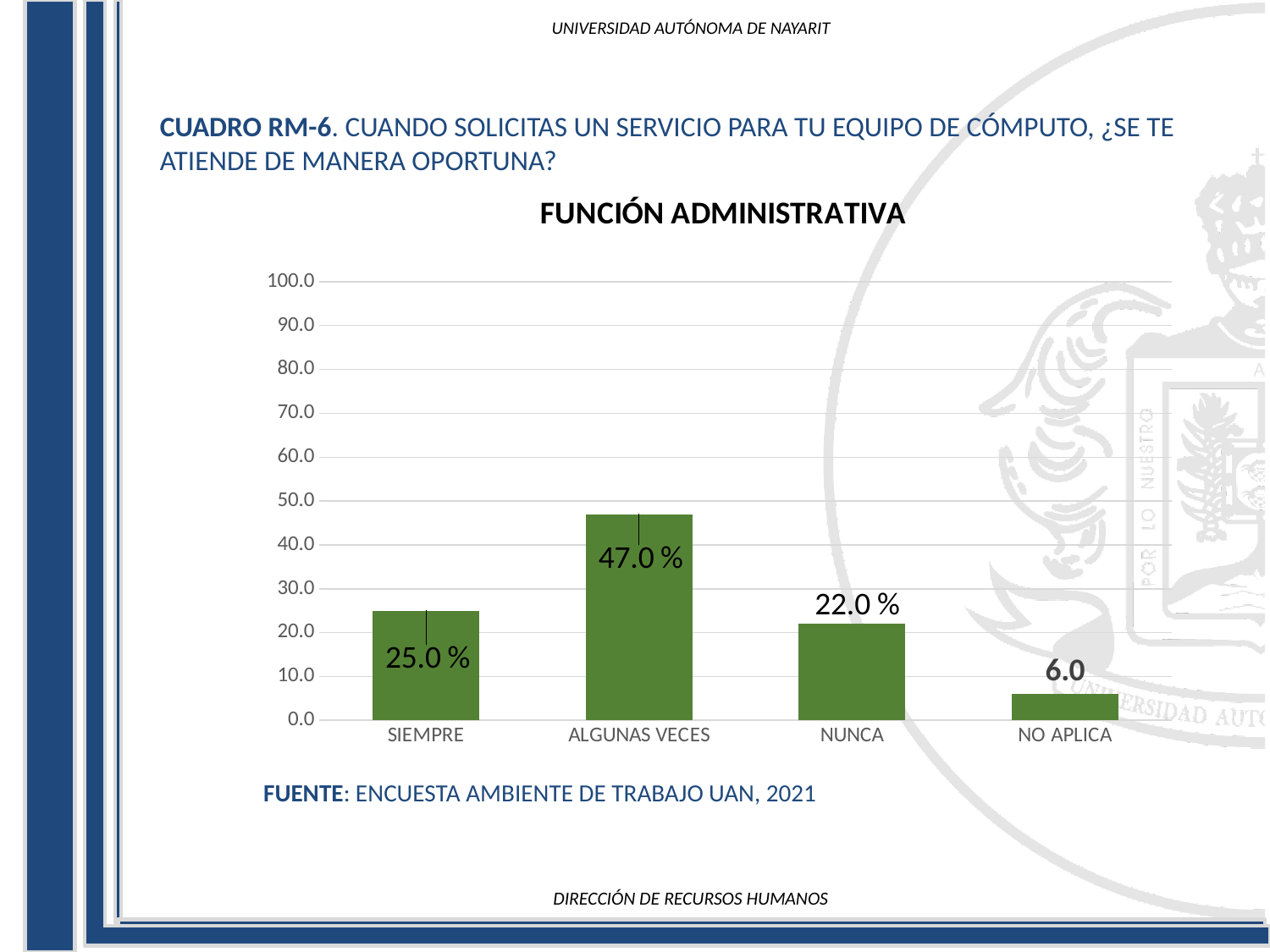
What is the value for NUNCA? 22.0 % What is the value for SIEMPRE? 25.0 % Is the value for ALGUNAS VECES greater or less than 50.0? less What kind of chart is shown? bar chart Which category has the highest value? ALGUNAS VECES What is the value shown for NO APLICA? 6.0 What is the title of the chart? FUNCIÓN ADMINISTRATIVA How many categories are shown on the x axis? 4 Which is larger, the value for SIEMPRE or the value for NUNCA? SIEMPRE Which category has the lowest value? NO APLICA What is the value for ALGUNAS VECES? 47.0 % What is the difference between the values for ALGUNAS VECES and SIEMPRE? 22.0 %